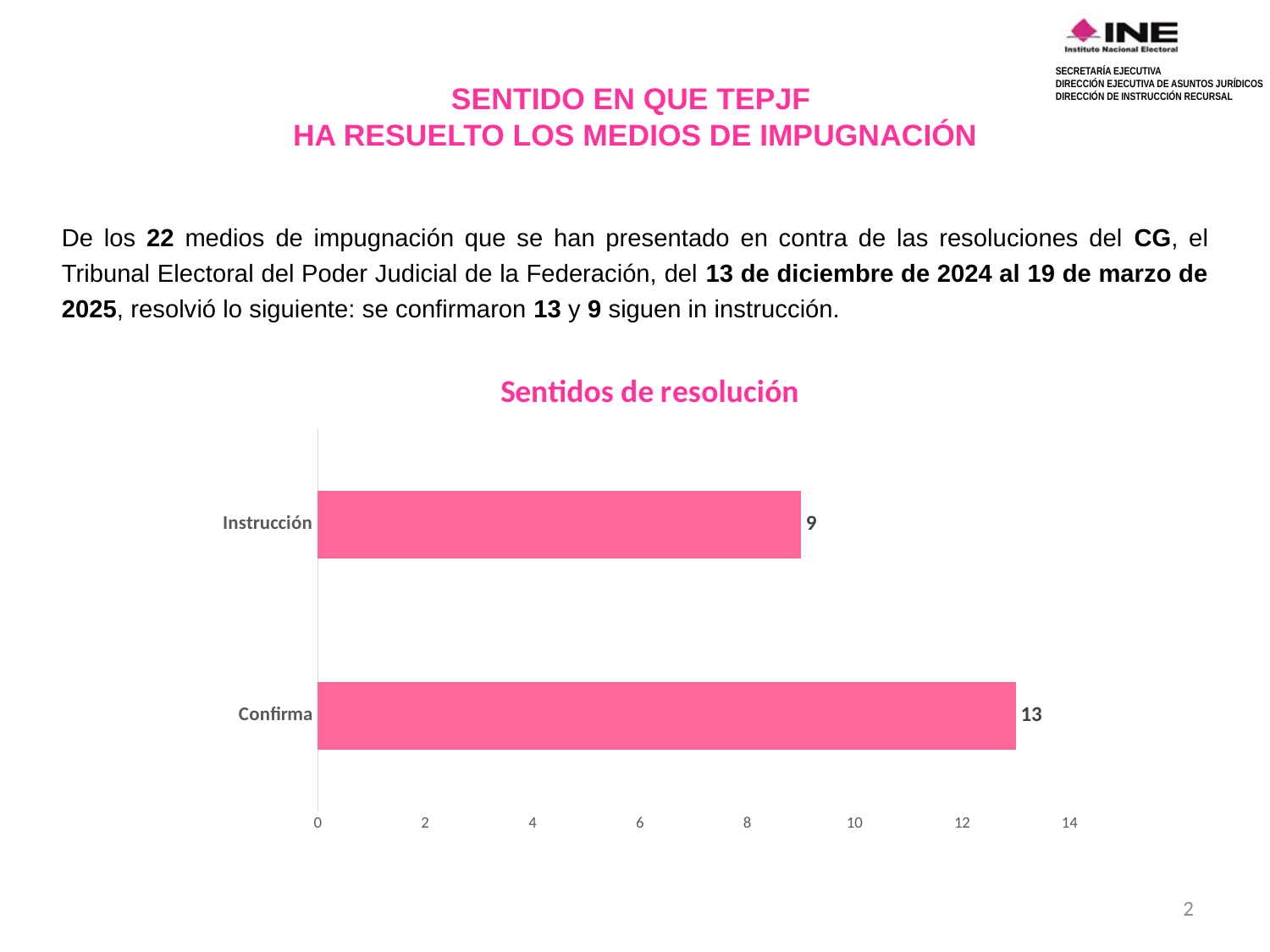
What is the difference between the values for Confirma and Instrucción? 4 Which is larger, the value for Confirma or the value for Instrucción? Confirma How many categories are shown in the chart? 2 Is the value for Instrucción greater or less than 10? less Is the value for Confirma greater or less than 12? greater What is the value for Confirma in the chart? 13 What is the value for Instrucción in the chart? 9 What is the title of the chart? Sentidos de resolución Which category has the lowest value in the chart? Instrucción Which category has the highest value in the chart? Confirma What kind of chart is shown on the slide? Bar chart What is the maximum value shown on the horizontal axis of the chart? 14